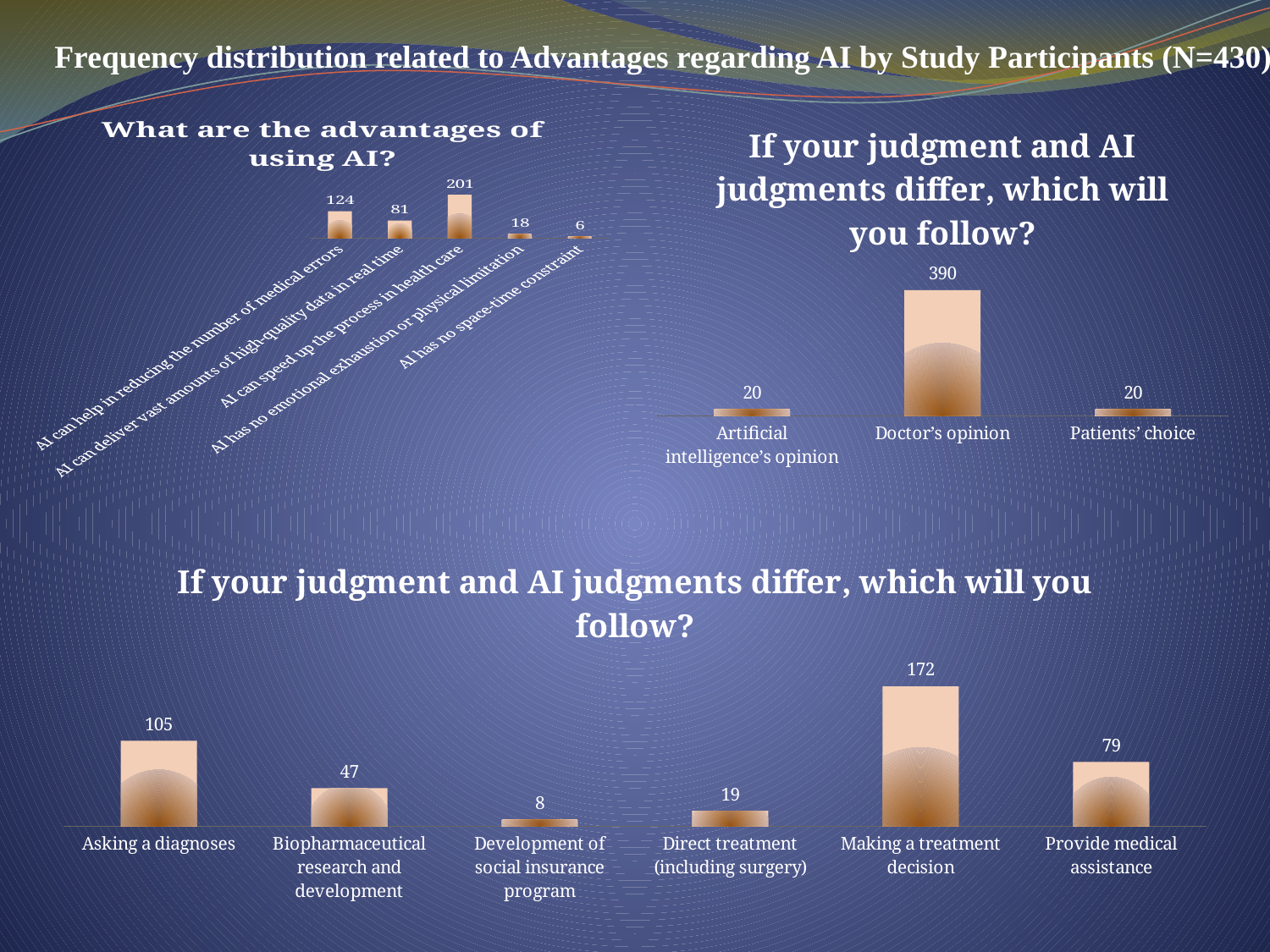
In the top-left chart titled 'What are the advantages of using AI?', what is the difference between the values for 'AI can help in reducing the number of medical errors' and 'AI can deliver vast amounts of high-quality data in real time'? 43 How many categories are shown in the top-left chart titled 'What are the advantages of using AI?'? 5 In the top-right chart, what is the value for 'Doctor's opinion'? 390 In the top-left chart titled 'What are the advantages of using AI?', what is the value for 'AI can speed up the process in health care'? 201 In the top-right chart, which category has the highest value? Doctor's opinion In the top-left chart titled 'What are the advantages of using AI?', which category has the lowest value? AI has no space-time constraint In the bottom chart, which category has the lowest value? Development of social insurance program In the bottom chart, what is the value for 'Making a treatment decision'? 172 In the top-right chart, what is the difference between the values for 'Doctor's opinion' and 'Patients' choice'? 370 What kind of chart is the bottom chart on the slide? Bar chart How many categories are shown in the bottom chart? 6 In the bottom chart, which is larger: the value for 'Asking a diagnoses' or the value for 'Provide medical assistance'? Asking a diagnoses